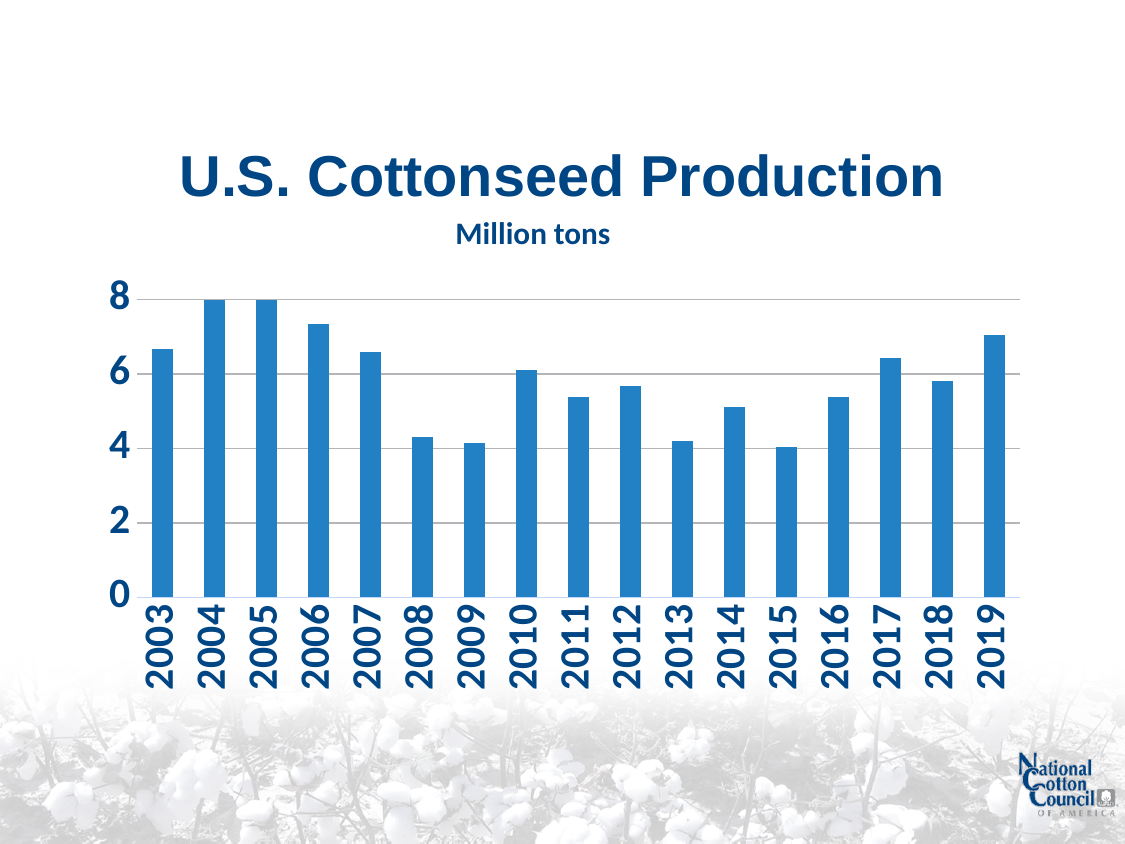
In what units is cottonseed production plotted? Million tons Is the value for 2019 greater or less than 6? greater Is the value for 2006 greater or less than 6? greater What is the title of the chart? U.S. Cottonseed Production Is the value for 2011 greater or less than 6? less Which year has the larger value, 2006 or 2008? 2006 What kind of chart is shown on the slide? bar chart How many years are shown on the x axis? 17 Do the values rise or fall from 2005 to 2009? fall Which year has the larger value, 2010 or 2011? 2010 Which year has the larger value, 2015 or 2019? 2019